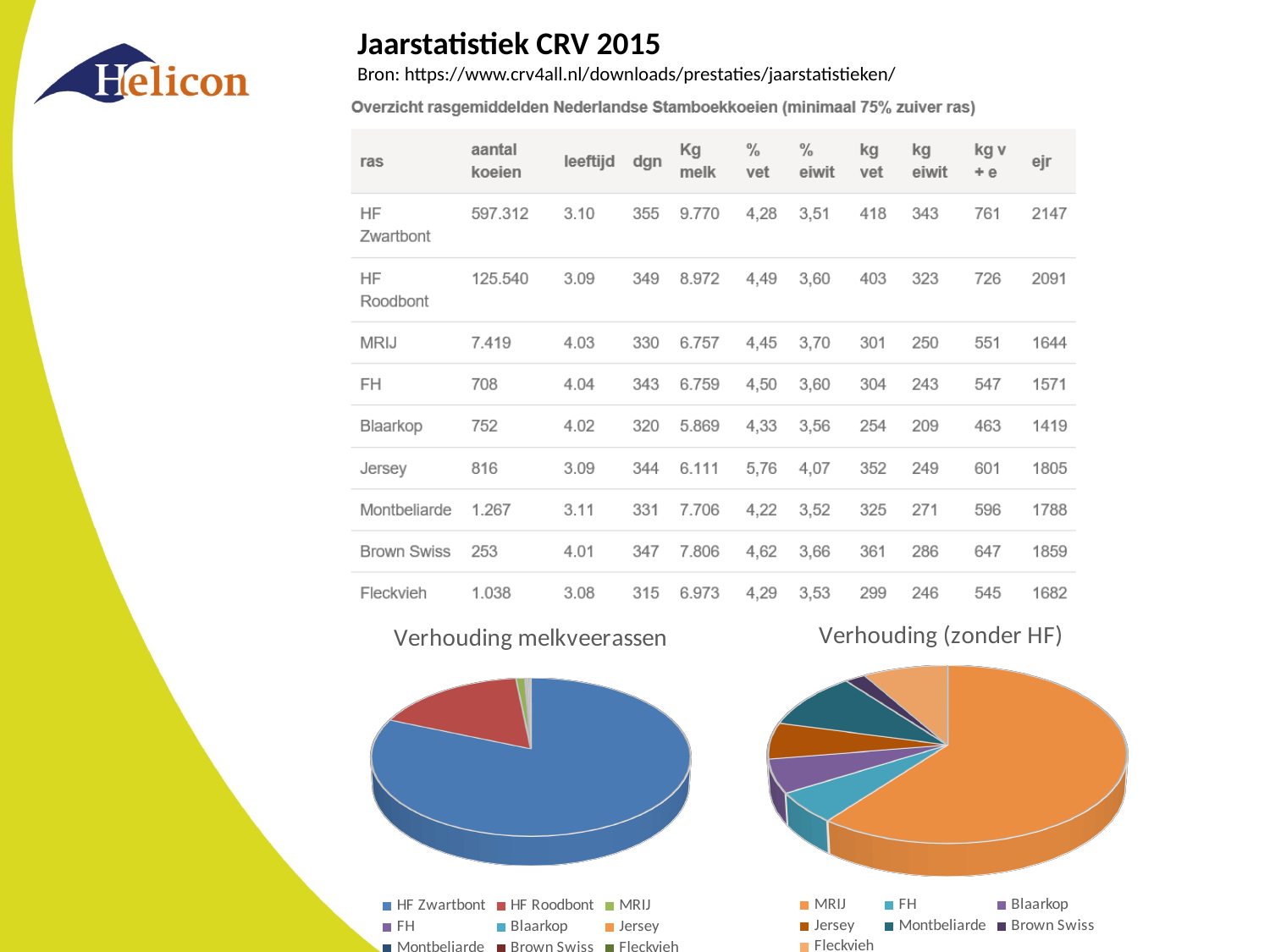
In the 'Verhouding (zonder HF)' chart, which slice is larger: MRIJ or Fleckvieh? MRIJ In the 'Verhouding melkveerassen' chart, which breed has the largest slice? HF Zwartbont In the 'Verhouding (zonder HF)' chart, which breed is shown in the large orange slice? MRIJ How many breeds are listed in the legend of the 'Verhouding melkveerassen' chart? 9 What is the title of the pie chart on the right side of the slide? Verhouding (zonder HF) In the 'Verhouding (zonder HF)' chart, which breed has the largest slice? MRIJ In the 'Verhouding (zonder HF)' chart, which slice is larger: Jersey or Brown Swiss? Jersey In the 'Verhouding melkveerassen' chart, which slice is larger: HF Zwartbont or HF Roodbont? HF Zwartbont What kind of chart is the 'Verhouding melkveerassen' chart? pie chart How many breeds are listed in the legend of the 'Verhouding (zonder HF)' chart? 7 What kind of chart is the 'Verhouding (zonder HF)' chart? pie chart In the 'Verhouding (zonder HF)' chart, which breed has the smallest slice? Brown Swiss